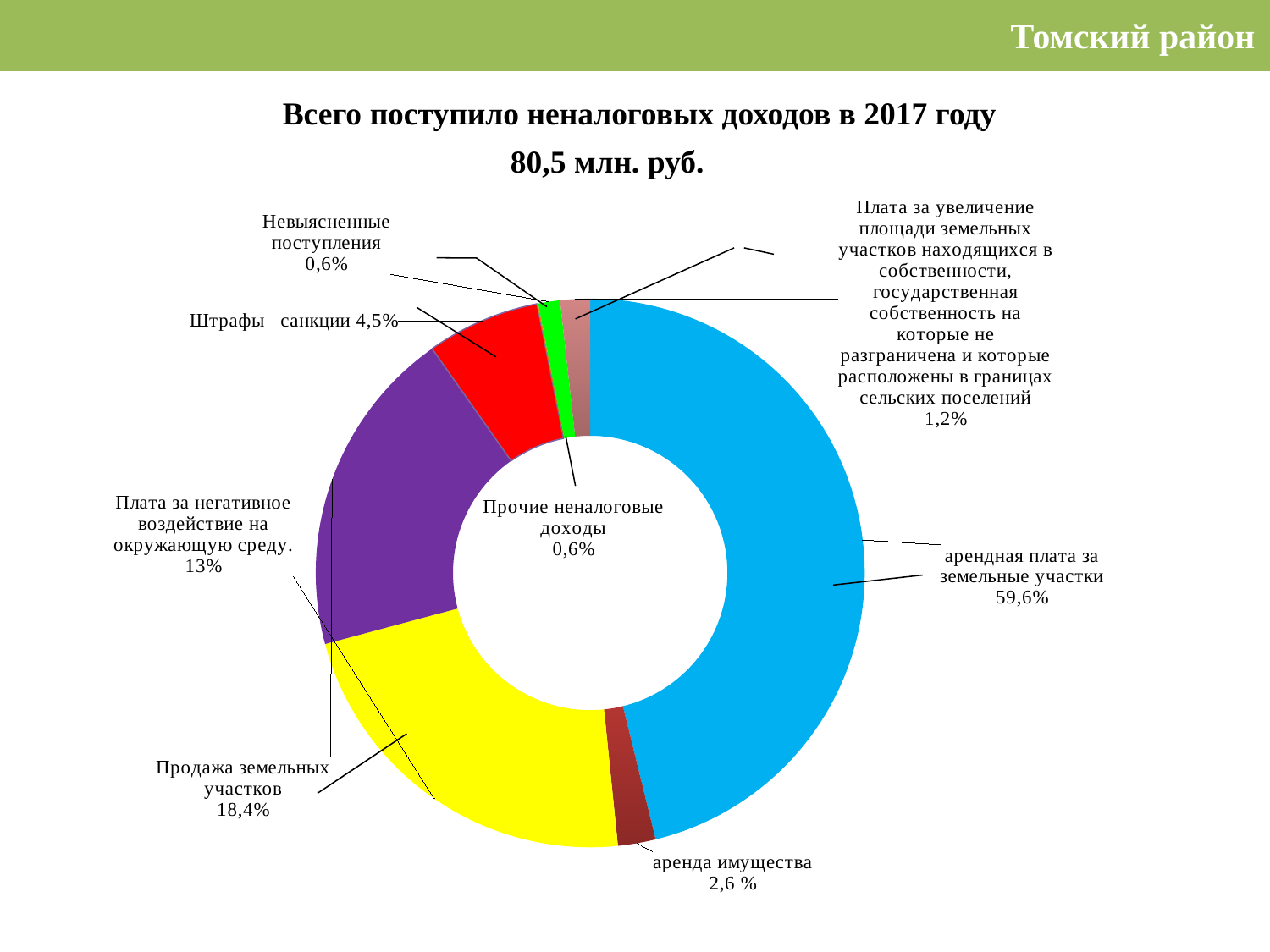
How many categories are shown in the chart? 8 What percentage is shown for Невыясненные поступления? 0,6% What total amount of non-tax revenue for 2017 is stated in the chart title? 80,5 млн. руб. What share is labelled for аренда имущества? 2,6 % Which is larger: Плата за негативное воздействие на окружающую среду or Штрафы санкции? Плата за негативное воздействие на окружающую среду What type of chart is shown on the slide? Doughnut (pie) chart What share of the pie does арендная плата за земельные участки have? 59,6% What percentage is shown for Продажа земельных участков? 18,4% What percentage is shown for Штрафы санкции? 4,5% What is the difference in percentage points between арендная плата за земельные участки and Продажа земельных участков? 41,2 Which category has the largest share of the chart? арендная плата за земельные участки What is the value labelled for Плата за негативное воздействие на окружающую среду? 13%